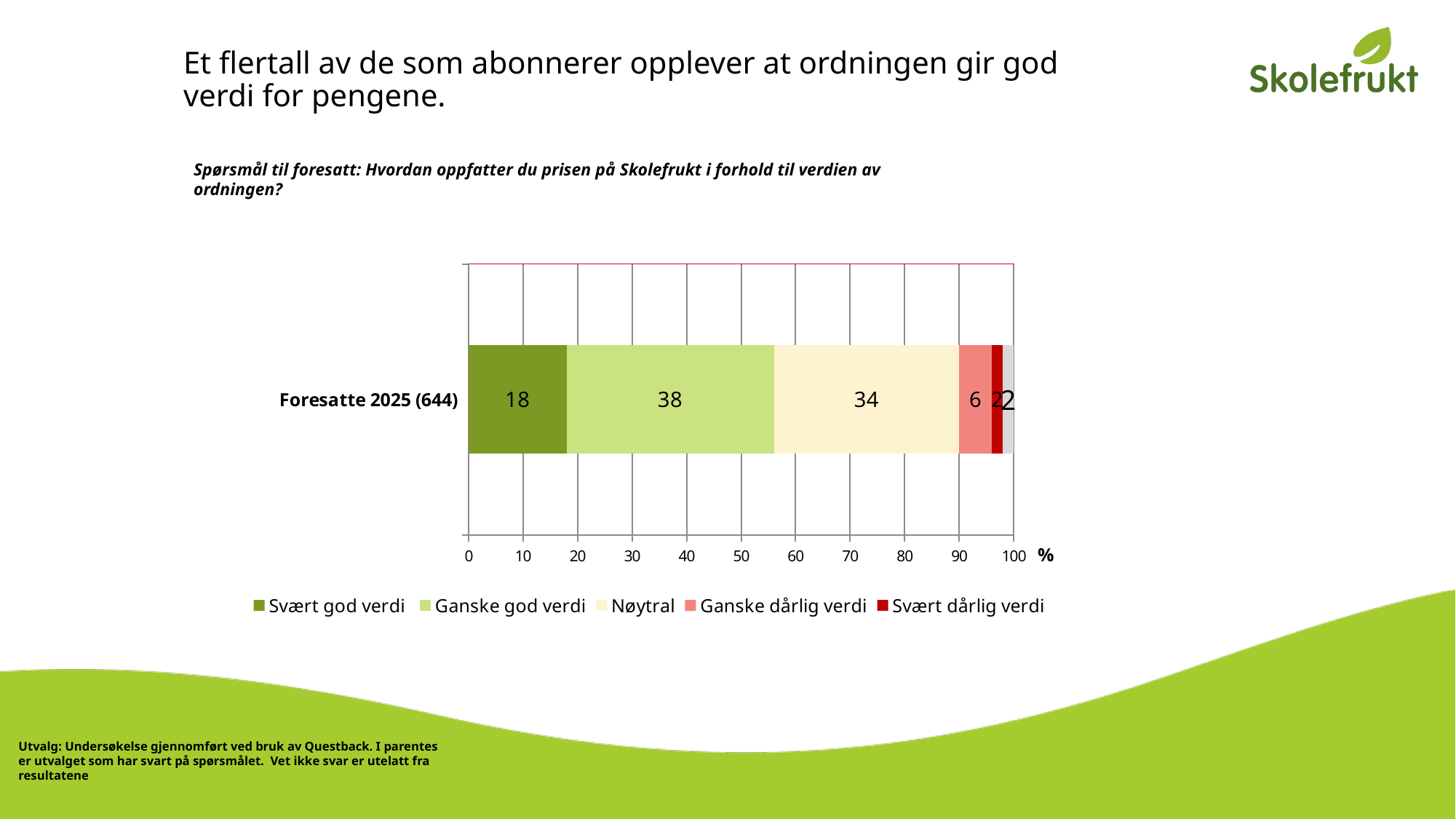
Which is larger for Foresatte 2025 (644): Svært god verdi or Nøytral? Nøytral What is the value for Ganske dårlig verdi for Foresatte 2025 (644)? 6 How many series does the legend list? 5 What is the value for Svært god verdi for Foresatte 2025 (644)? 18 What is the value for Nøytral for Foresatte 2025 (644)? 34 Which legend series has the largest segment in the bar for Foresatte 2025 (644)? Ganske god verdi Which legend series has the smallest segment in the bar for Foresatte 2025 (644)? Svært dårlig verdi What is the value for Ganske god verdi for Foresatte 2025 (644)? 38 What kind of chart is shown on the slide? Stacked bar chart What is the difference between the Ganske god verdi and Nøytral values for Foresatte 2025 (644)? 4 How many categories (bars) are plotted in the chart? 1 What is the difference between the Svært god verdi and Ganske dårlig verdi values for Foresatte 2025 (644)? 12